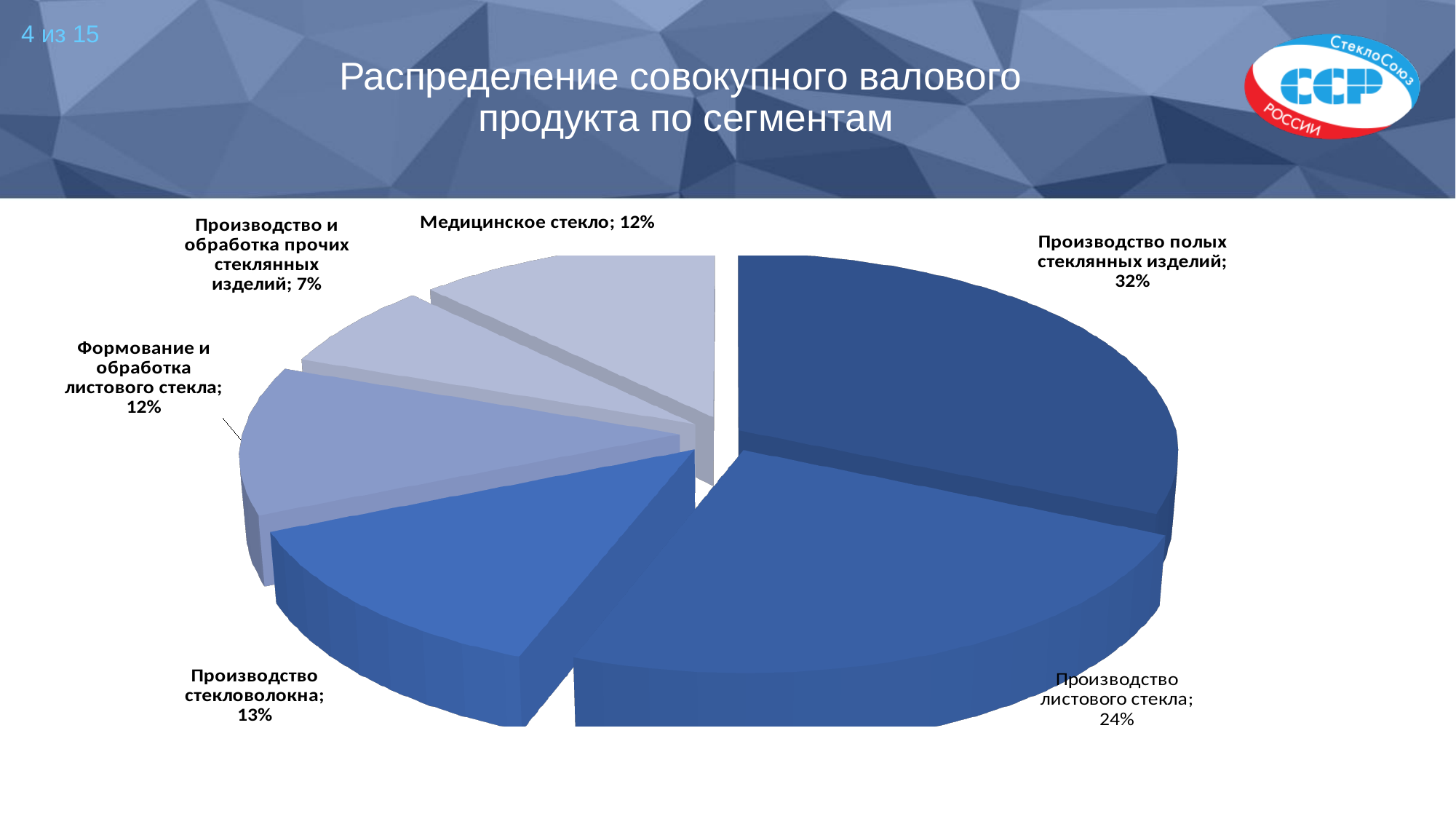
What is the title of the chart on the slide? Распределение совокупного валового продукта по сегментам How many segments does the pie chart have? 6 What share of the pie does Производство и обработка прочих стеклянных изделий have? 7% Which is larger: the share for Производство стекловолокна or the share for Формование и обработка листового стекла? Производство стекловолокна Which segment has the largest share of the pie? Производство полых стеклянных изделий What share of the pie does Производство листового стекла have? 24% What share of the pie does Производство стекловолокна have? 13% What kind of chart is shown on the slide? Pie chart What share of the pie does Медицинское стекло have? 12% What share of the pie does Производство полых стеклянных изделий have? 32% Which segment has the smallest share of the pie? Производство и обработка прочих стеклянных изделий What is the difference in percentage points between Производство полых стеклянных изделий and Производство листового стекла? 8